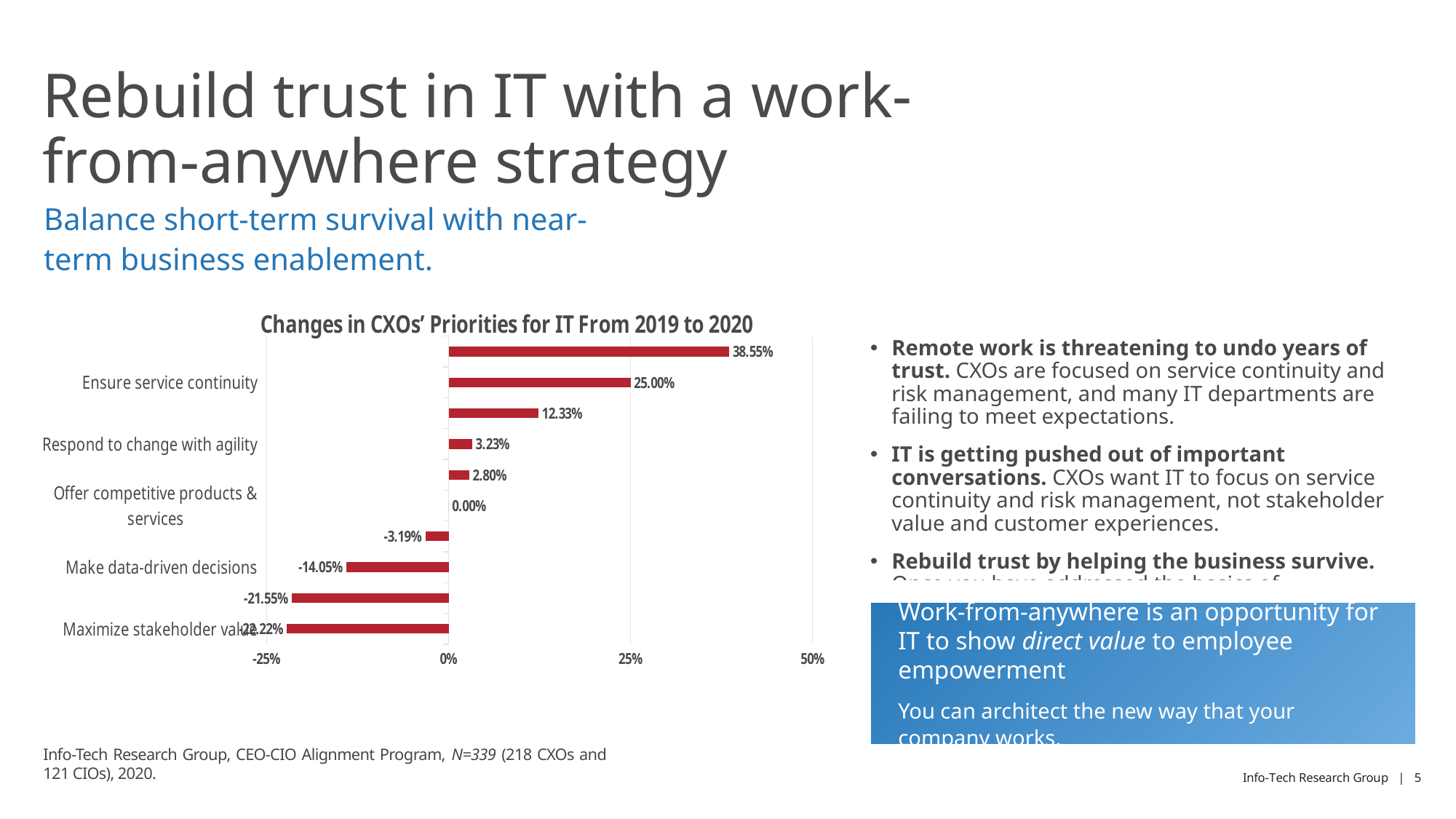
What is the value for Offer competitive products & services? 0.00% What is the value for Make data-driven decisions? -14.05% What is the value for Respond to change with agility? 3.23% How many bars are plotted in the chart? 10 What is the difference between the values for Ensure service continuity and Respond to change with agility? 21.77% What is the value for Ensure service continuity? 25.00% What kind of chart is shown on the slide? Bar chart Is the value for Make data-driven decisions greater or less than 0%? less What is the title of the chart? Changes in CXOs' Priorities for IT From 2019 to 2020 Which has the larger value, Ensure service continuity or Make data-driven decisions? Ensure service continuity Among the labeled categories, which has the lowest value? Maximize stakeholder value What is the largest value shown in the chart? 38.55%